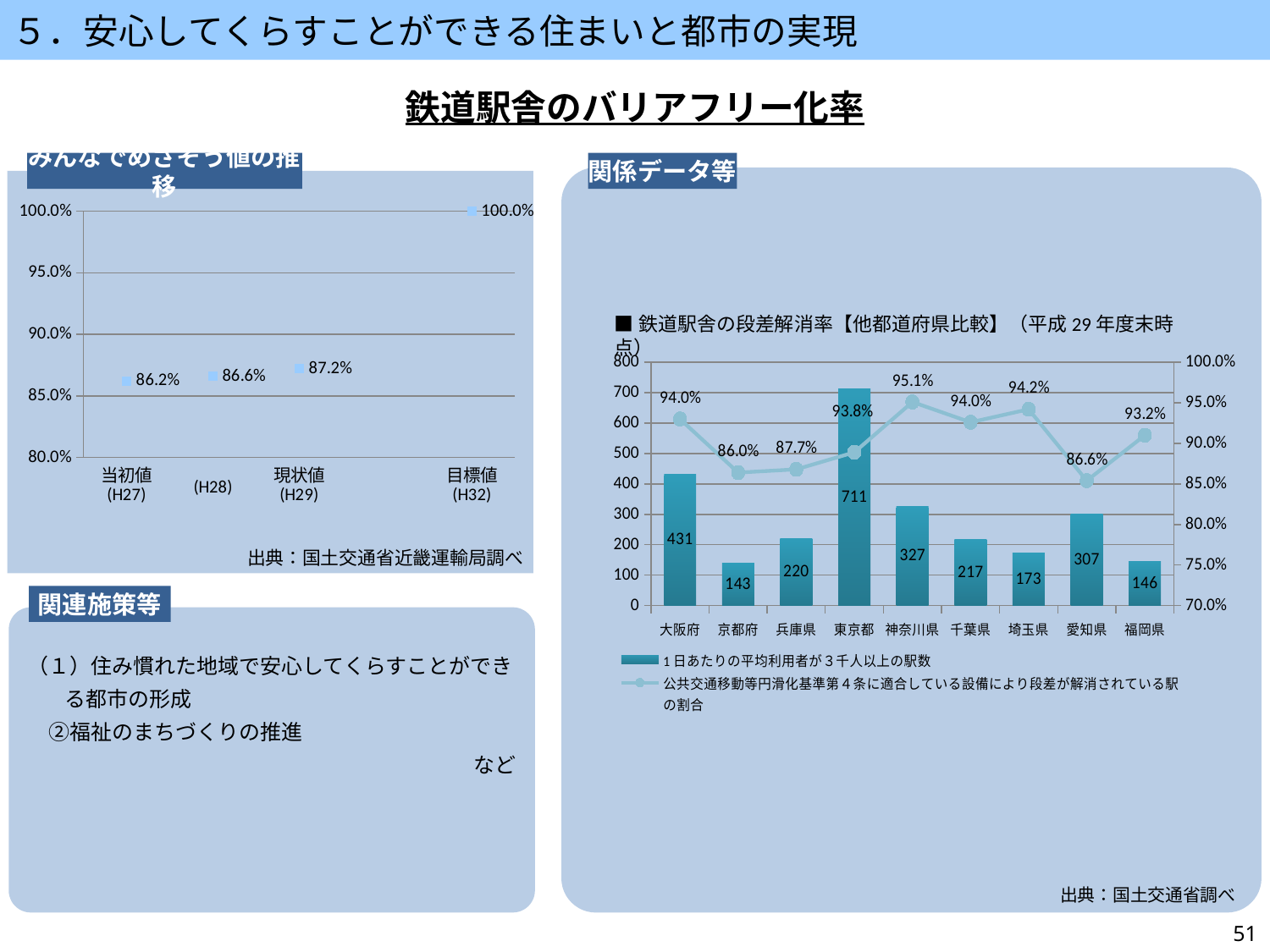
In the left chart (みんなでめざそう値の推移), how many data points are plotted? 4 In the right chart (鉄道駅舎の段差解消率【他都道府県比較】), what is the difference in station count between 大阪府 and 愛知県? 124 In the right chart (鉄道駅舎の段差解消率【他都道府県比較】), which prefecture has the highest number of stations (bar)? 東京都 In the left chart (みんなでめざそう値の推移), do the values rise or fall from H27 to H32? rise In the right chart (鉄道駅舎の段差解消率【他都道府県比較】), how many series does the legend list? 2 In the right chart (鉄道駅舎の段差解消率【他都道府県比較】), what is the barrier-free rate (line value) for 神奈川県? 95.1% In the right chart (鉄道駅舎の段差解消率【他都道府県比較】), how many stations with 3,000 or more average daily users does 東京都 have? 711 In the left chart (みんなでめざそう値の推移), what is the value for 目標値 (H32)? 100.0% In the left chart (みんなでめざそう値の推移), what is the value for 当初値 (H27)? 86.2% In the right chart (鉄道駅舎の段差解消率【他都道府県比較】), which has a higher barrier-free rate, 兵庫県 or 福岡県? 福岡県 In the right chart (鉄道駅舎の段差解消率【他都道府県比較】), which prefecture has the lowest number of stations (bar)? 京都府 In the right chart (鉄道駅舎の段差解消率【他都道府県比較】), how many prefectures are shown on the x axis? 9